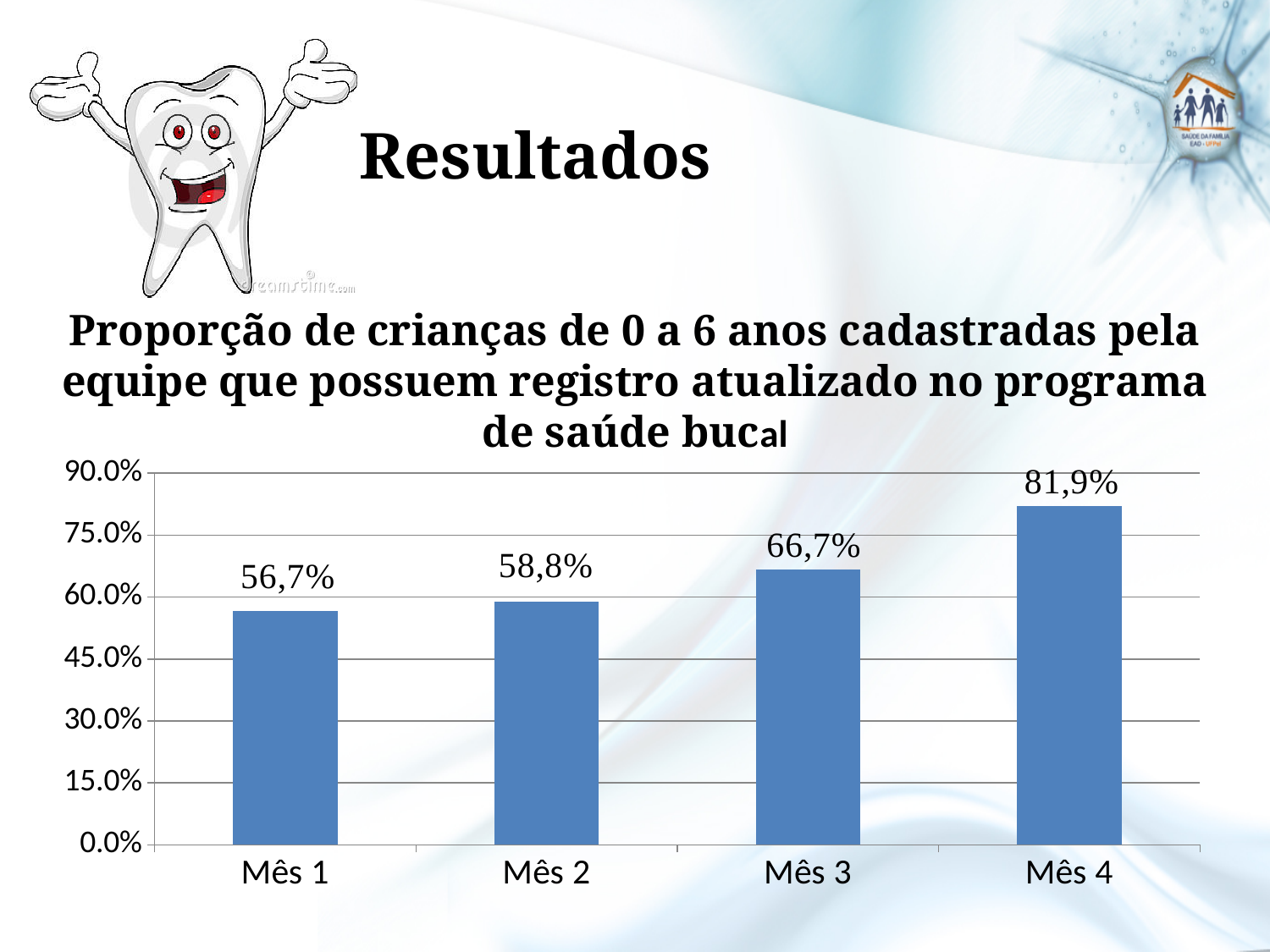
How many months are shown on the x axis? 4 What is the difference between the values for Mês 4 and Mês 1? 25,2% Which month has the highest value? Mês 4 What is the value for Mês 1? 56,7% Which month has the lowest value? Mês 1 What is the value for Mês 3? 66,7% What is the value for Mês 4? 81,9% Do the values rise or fall from Mês 1 to Mês 4? rise What is the difference between the values for Mês 3 and Mês 2? 7,9% Which is larger, the value for Mês 2 or the value for Mês 3? Mês 3 Is the value for Mês 4 greater or less than 75.0%? greater What kind of chart is shown on the slide? bar chart